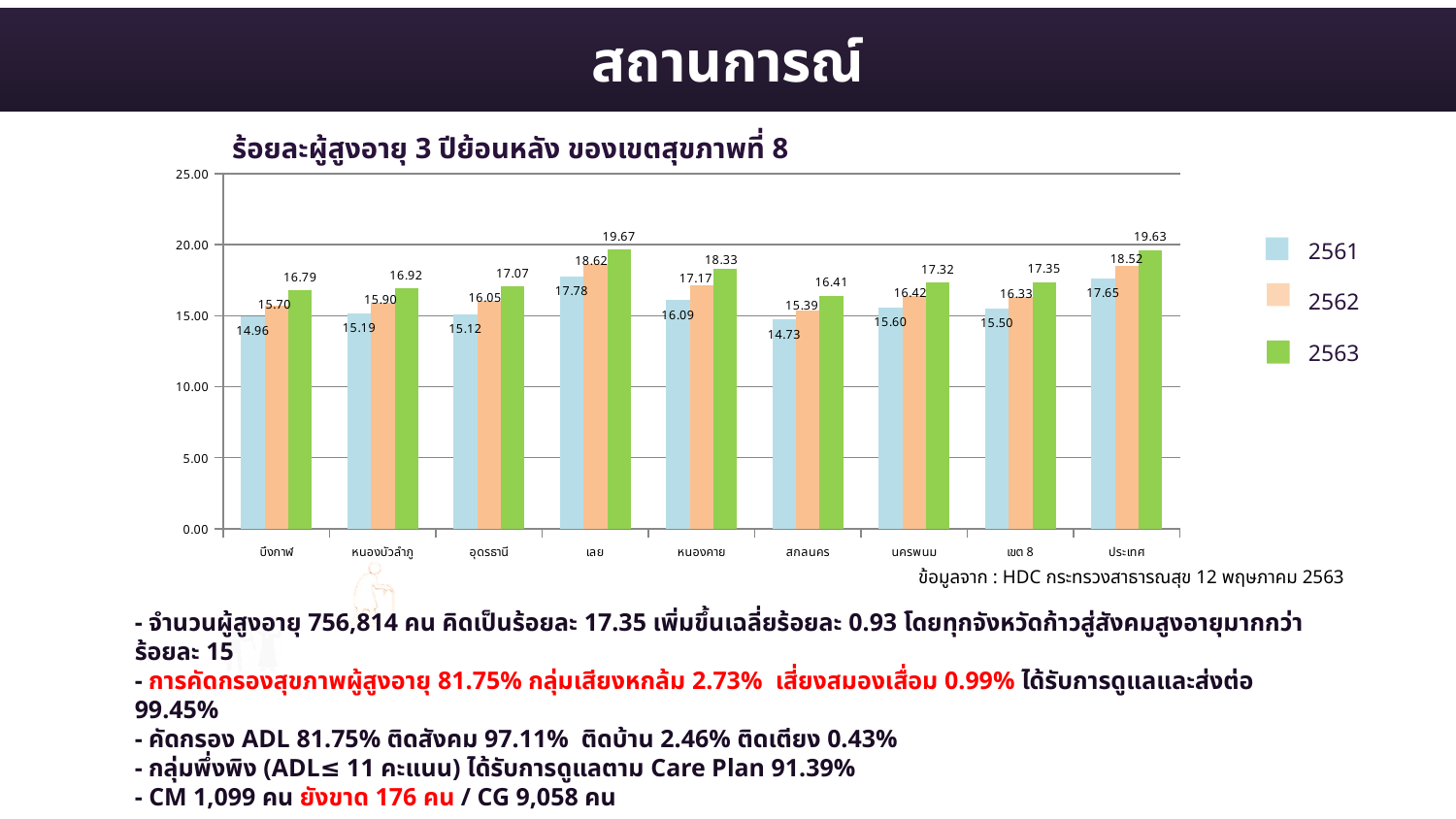
What is the title of the chart? ร้อยละผู้สูงอายุ 3 ปีย้อนหลัง ของเขตสุขภาพที่ 8 Which category has the highest value in 2563? เลย How many categories are shown on the x axis? 9 How many series does the legend list? 3 Which category has the lowest value in 2561? สกลนคร What is the value for เขต 8 in 2562? 16.33 What type of chart is shown on the slide? bar chart What is the value for สกลนคร in 2561? 14.73 For บึงกาฬ, do the values rise or fall from 2561 to 2563? rise What is the difference between the 2563 and 2561 values for หนองคาย? 2.24 Which is larger, the 2562 value for นครพนม or the 2562 value for อุดรธานี? นครพนม What is the value for เลย in 2563? 19.67